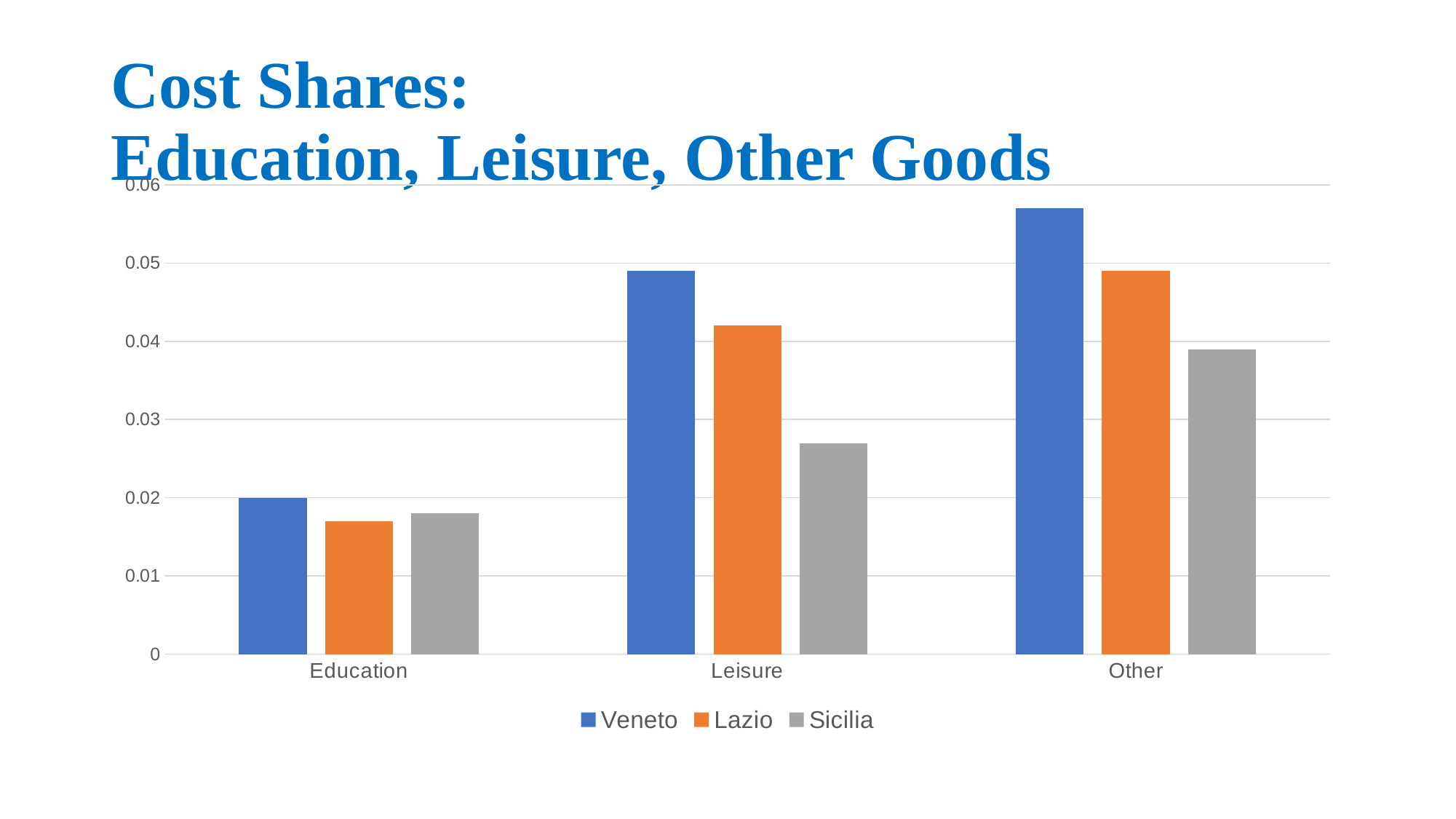
Is the value for Sicilia in the Leisure category greater or less than 0.03? less Which series has the lowest value in the Leisure category? Sicilia Is the value for Lazio in the Education category greater or less than 0.02? less How many categories are shown on the x axis? 3 What kind of chart is shown on the slide? Bar chart Is the value for Veneto in the Other category greater or less than 0.05? greater In the Leisure category, which is larger, the value for Veneto or the value for Lazio? Veneto Do the Veneto values rise or fall from Education to Other along the x axis? rise Which category has the highest Veneto value? Other Which series has the highest value in the Other category? Veneto What is the value for Veneto in the Education category? 0.02 How many series does the legend list? 3